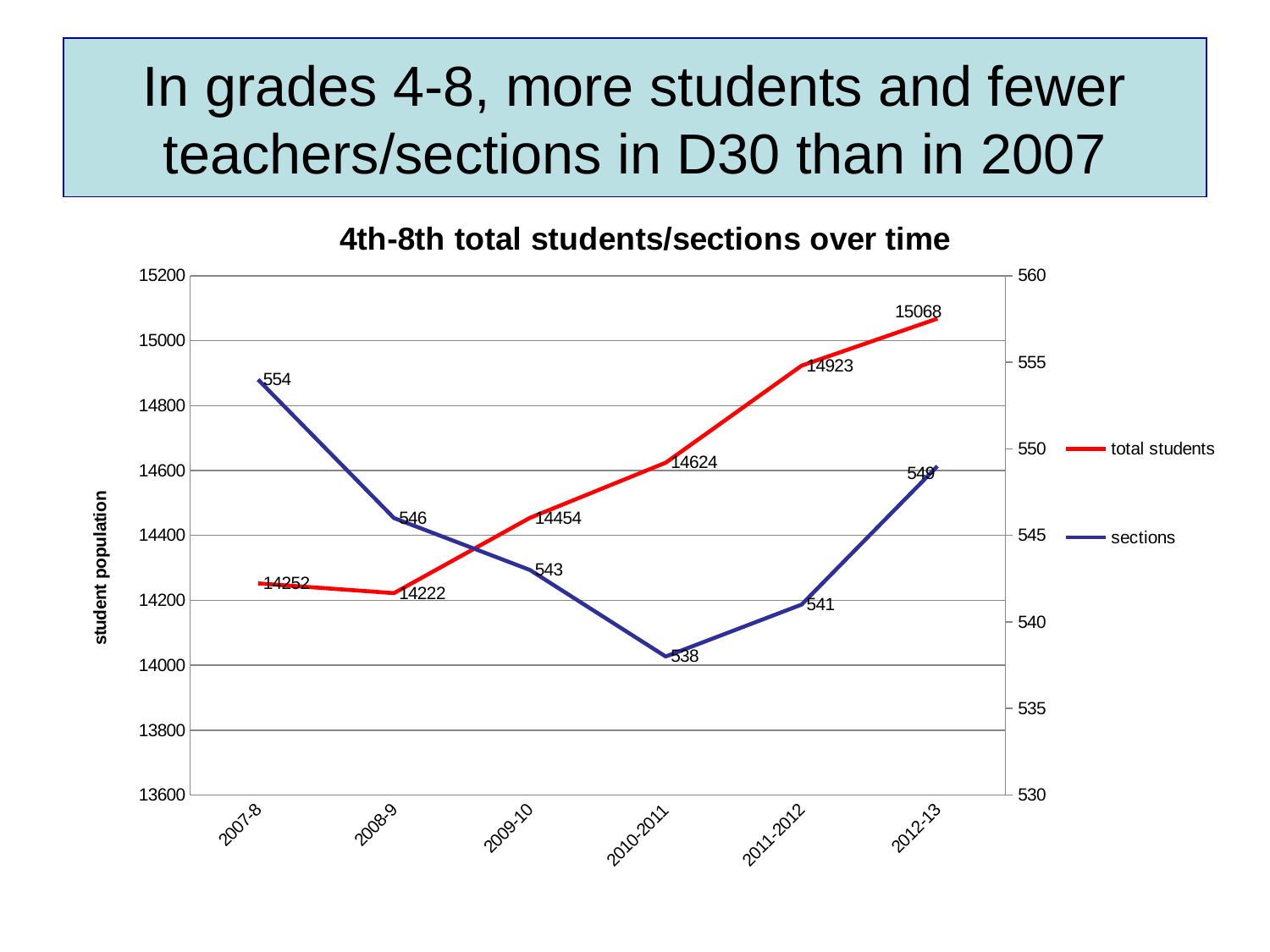
What is the difference in total students between 2012-13 and 2007-8? 816 How many school years are plotted along the x axis? 6 What is the title of the chart? 4th-8th total students/sections over time What is the total students value for 2010-2011? 14624 Does the total students series generally rise or fall from 2008-9 to 2012-13? rise What is the sections value for 2008-9? 546 Which is larger, the total students value for 2008-9 or for 2009-10? 2009-10 In which school year is the sections value lowest? 2010-2011 In which school year is the total students value highest? 2012-13 What is the difference in sections between 2007-8 and 2012-13? 5 How many series does the legend list? 2 What kind of chart is shown on the slide? line chart